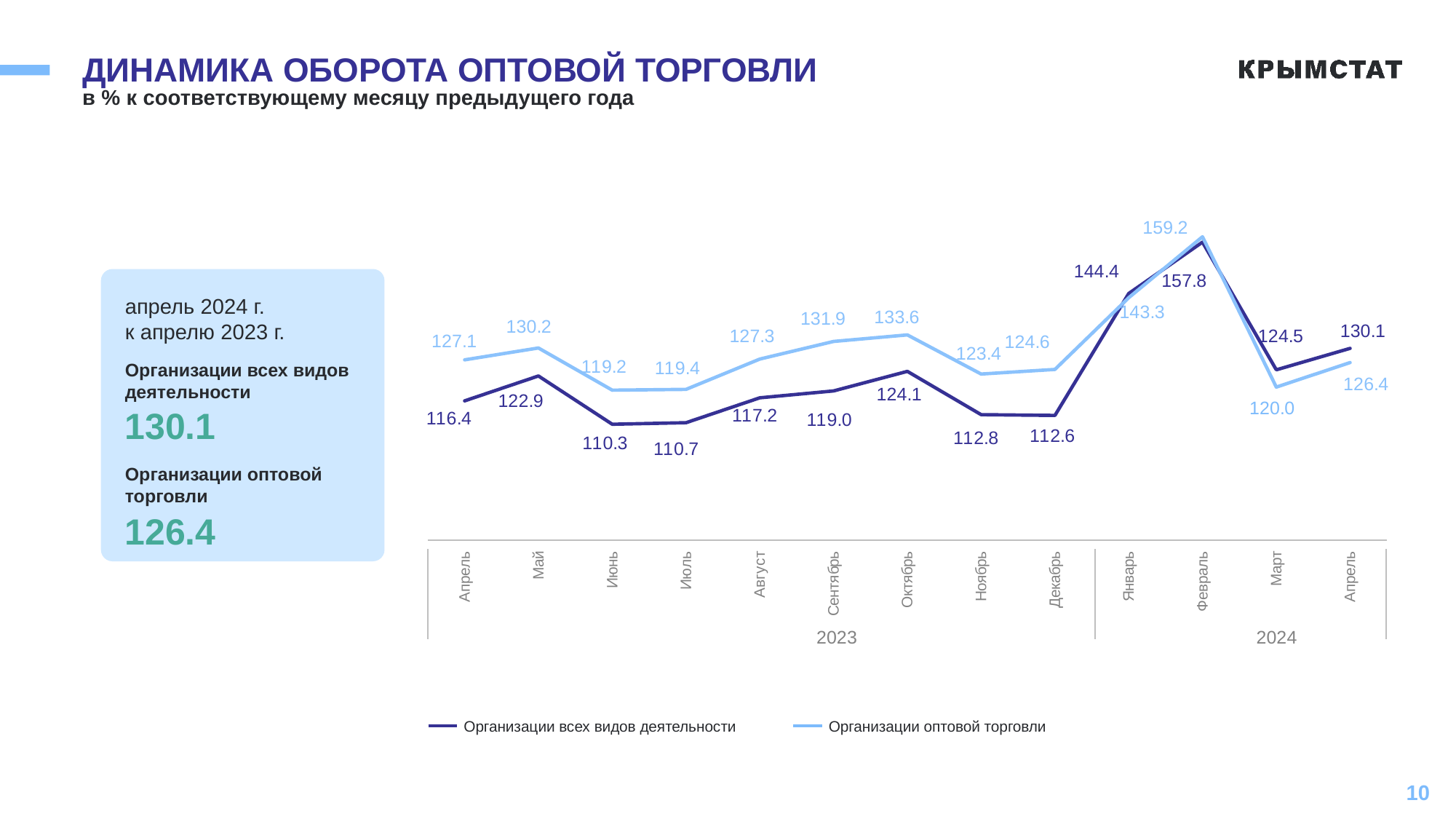
What type of chart is shown on the slide? line chart Does the value for Организации всех видов деятельности rise or fall from Февраль 2024 to Март 2024? fall In which month does Организации оптовой торговли reach its highest value? Февраль 2024 Which series has the higher value in Март 2024? Организации всех видов деятельности How many series does the legend list? 2 Which colour is used for the Организации оптовой торговли line? light blue How many months (data points) are plotted along the x axis? 13 What is the value for Организации оптовой торговли in Март 2024? 120.0 What is the value for Организации оптовой торговли in Октябрь 2023? 133.6 What is the difference between Организации оптовой торговли and Организации всех видов деятельности in Апрель 2023? 10.7 What is the value for Организации всех видов деятельности in Июнь 2023? 110.3 In which month is the value for Организации всех видов деятельности the lowest? Июнь 2023